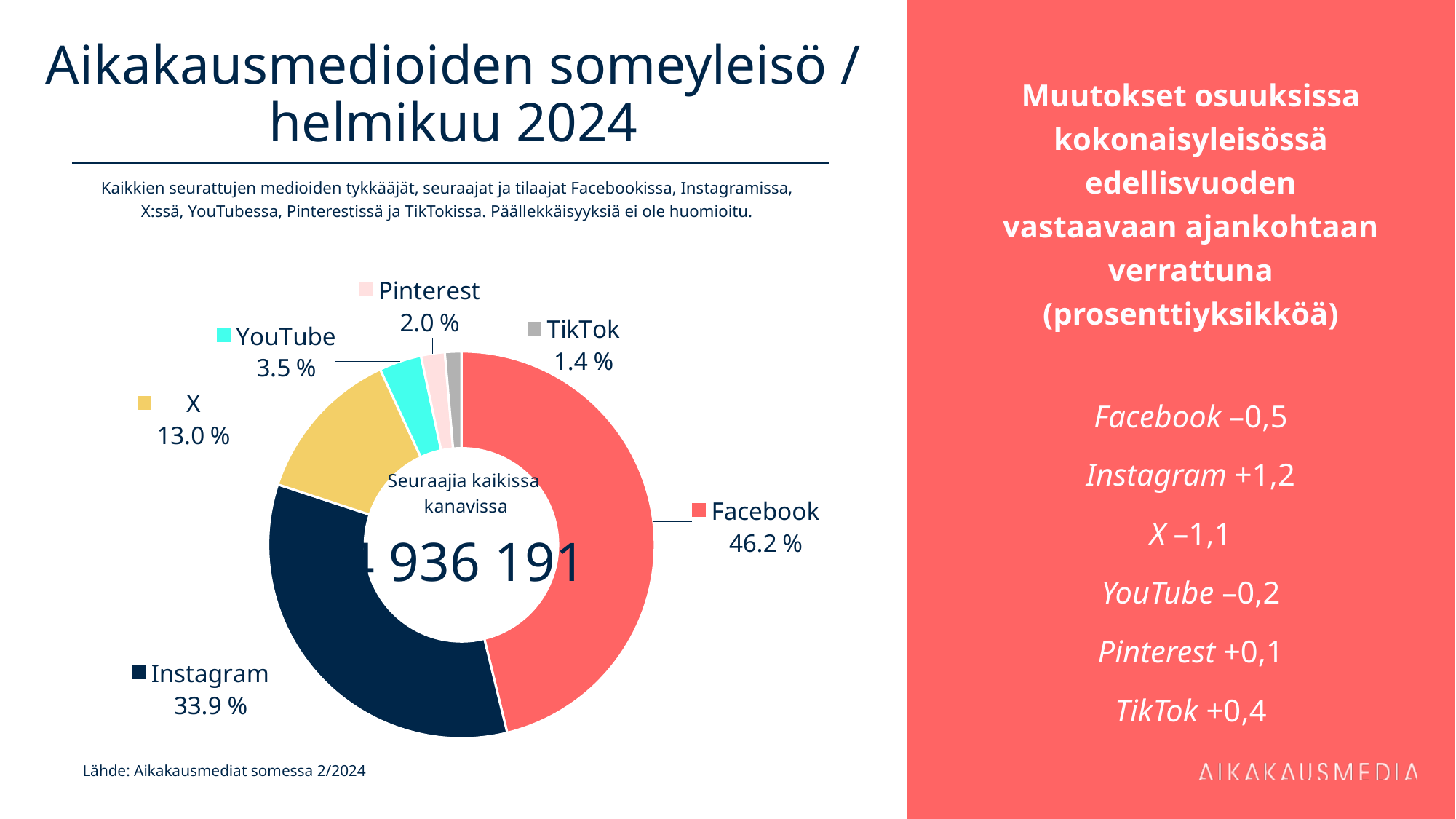
What share of the social media audience does Facebook hold according to the chart? 46.2 % What is the value shown for X in the chart? 13.0 % How many percentage points larger is Facebook's share than Instagram's? 12.3 What percentage does the chart show for YouTube? 3.5 % Which channel has the smallest share in the chart? TikTok What is the title of the slide containing the chart? Aikakausmedioiden someyleisö / helmikuu 2024 What is the value shown for TikTok? 1.4 % What percentage is shown for Instagram in the chart? 33.9 % Which has a larger share, Pinterest or YouTube? YouTube What type of chart is used on the slide? Pie chart (donut) Which channel has the largest share in the chart? Facebook How many channels are shown in the chart? 6